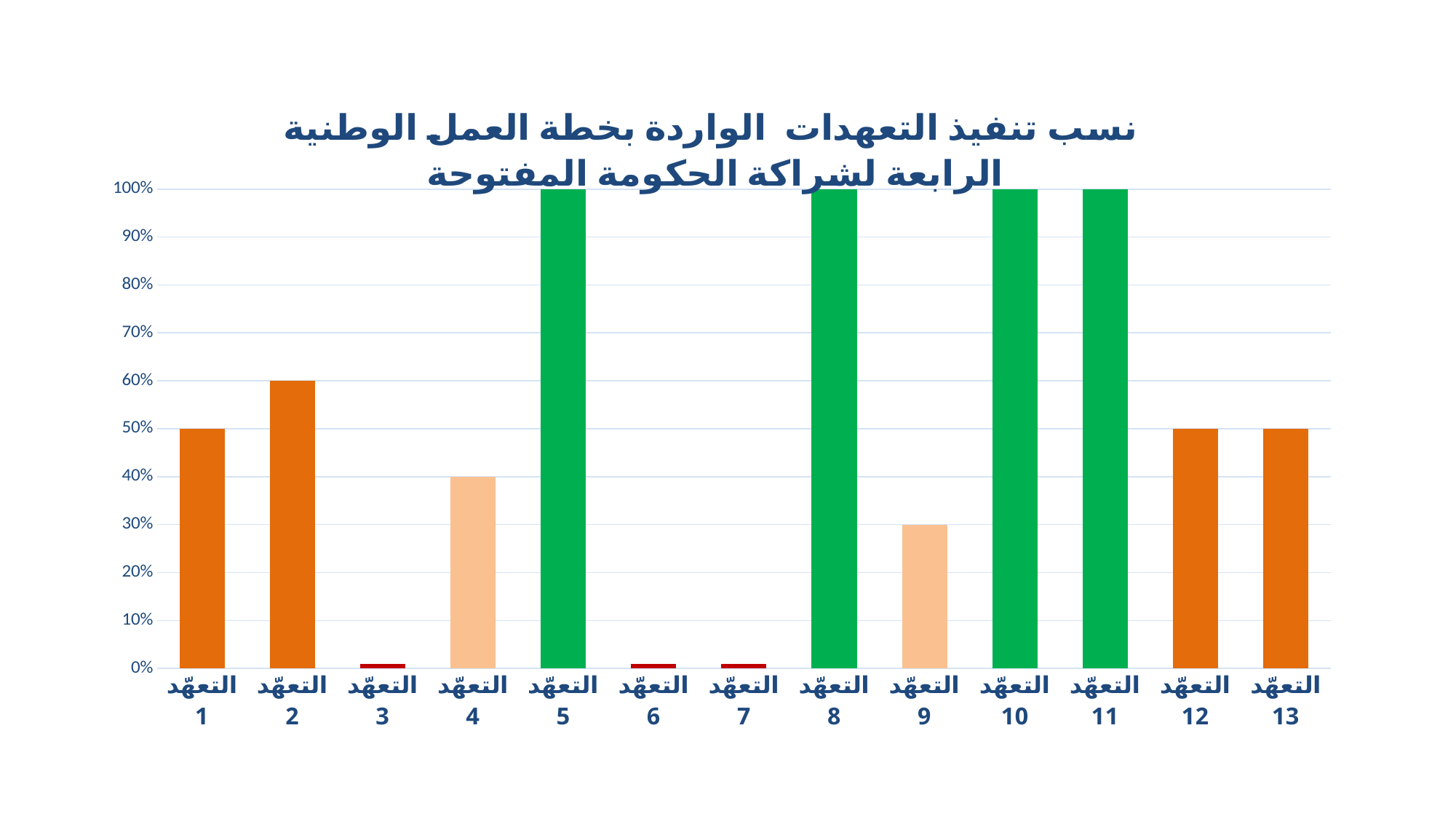
What is the implementation percentage for التعهّد 4? 40% Is the value for التعهّد 9 greater or less than 50%? less What is the implementation percentage for التعهّد 5? 100% How many commitments reach 100%? 4 What is the implementation percentage for التعهّد 2? 60% How many commitments (التعهّد) are shown on the x axis? 13 What type of chart is shown on the slide? bar chart What is the implementation percentage for التعهّد 9? 30% What is the implementation percentage for التعهّد 1? 50% What is the difference between the values for التعهّد 2 and التعهّد 4? 20% Which has a higher value, التعهّد 2 or التعهّد 9? التعهّد 2 What colour are the bars that reach 100%? green